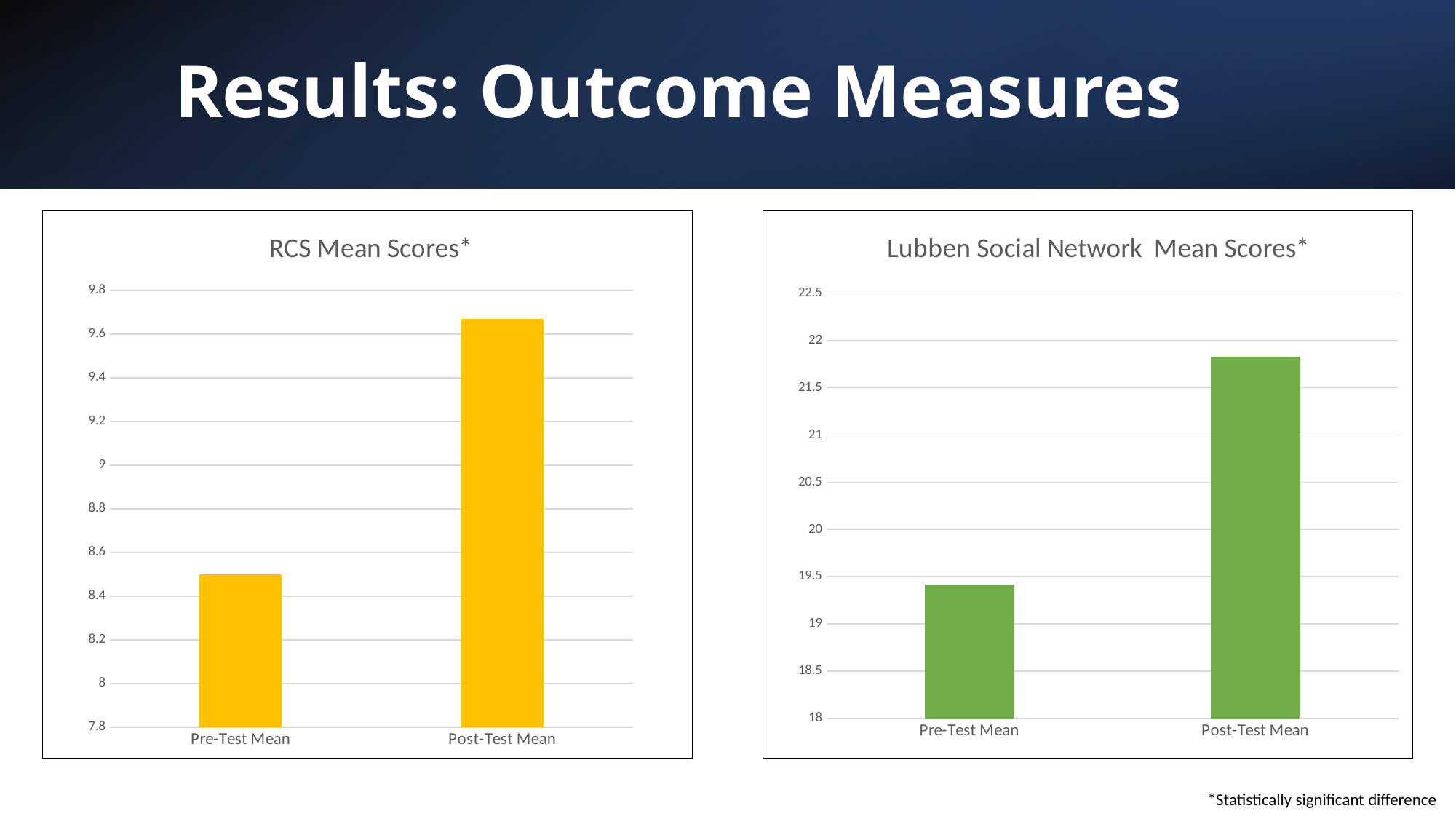
In the RCS Mean Scores chart, is the value for Post-Test Mean greater or less than 9.4? greater In the RCS Mean Scores chart, do the values rise or fall from Pre-Test Mean to Post-Test Mean? rise How many categories are shown in the RCS Mean Scores chart? 2 In the Lubben Social Network Mean Scores chart, is the value for Post-Test Mean greater or less than 21? greater In the Lubben Social Network Mean Scores chart, which category has the lowest value? Pre-Test Mean In the Lubben Social Network Mean Scores chart, is the value for Pre-Test Mean greater or less than 20? less In the RCS Mean Scores chart, which category has the highest value? Post-Test Mean In the Lubben Social Network Mean Scores chart, which is larger, Pre-Test Mean or Post-Test Mean? Post-Test Mean What colour are the bars in the Lubben Social Network Mean Scores chart? green What kind of chart is the Lubben Social Network Mean Scores chart? bar chart What kind of chart is the RCS Mean Scores chart? bar chart